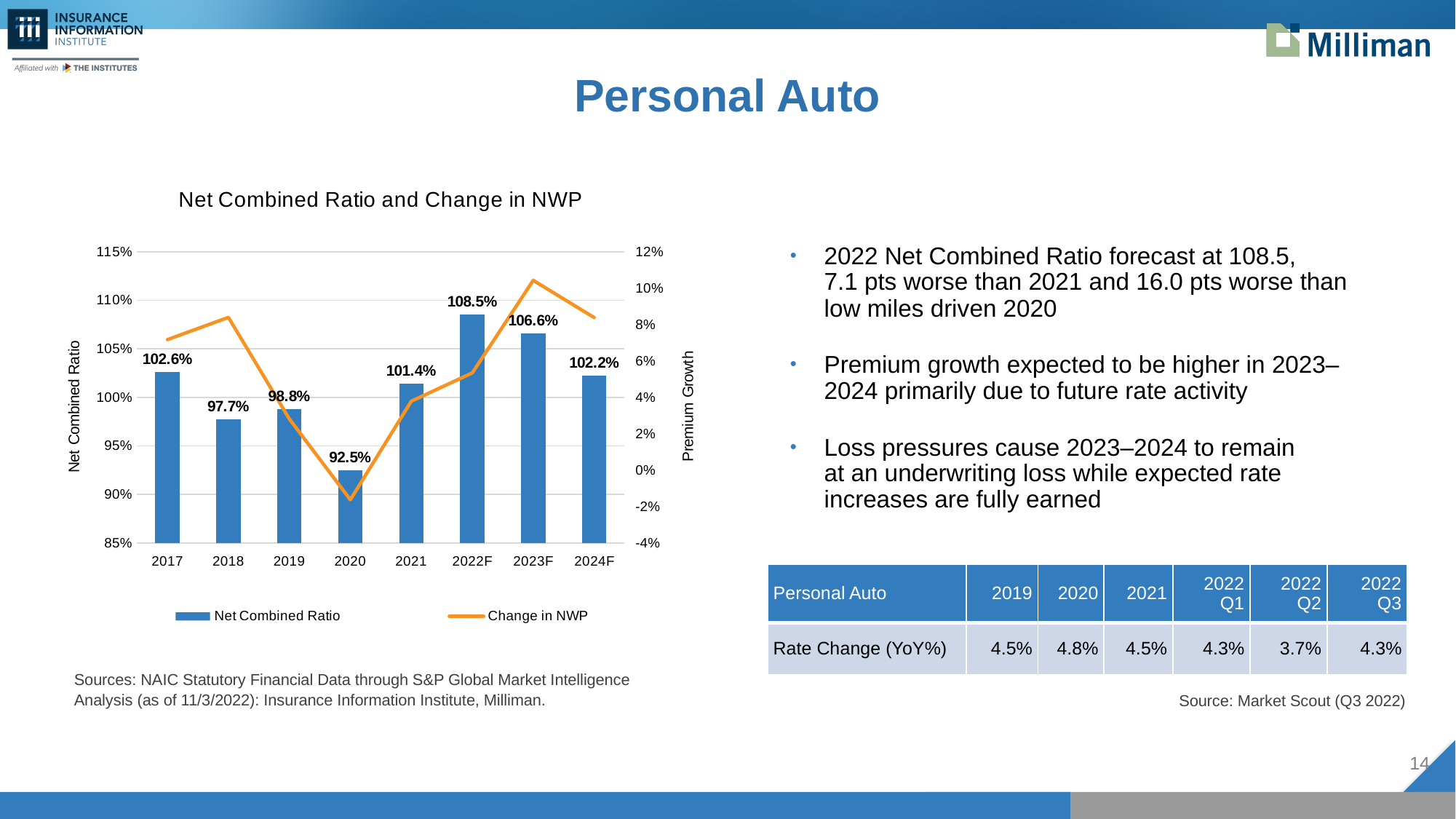
What is the Net Combined Ratio for 2022F? 108.5% Is the Change in NWP for 2018 greater or less than 6%? greater Which is larger, the Net Combined Ratio for 2017 or for 2024F? 2017 Which year has the lowest Net Combined Ratio? 2020 What is the Net Combined Ratio for 2018? 97.7% Does the Net Combined Ratio rise or fall from 2022F to 2024F? fall How many series does the chart legend list? 2 What is the Net Combined Ratio for 2020? 92.5% How many years are shown on the x axis of the chart? 8 Which year has the highest Net Combined Ratio? 2022F Is the Change in NWP for 2020 greater or less than 0%? less What is the difference between the Net Combined Ratio for 2022F and 2021? 7.1 points